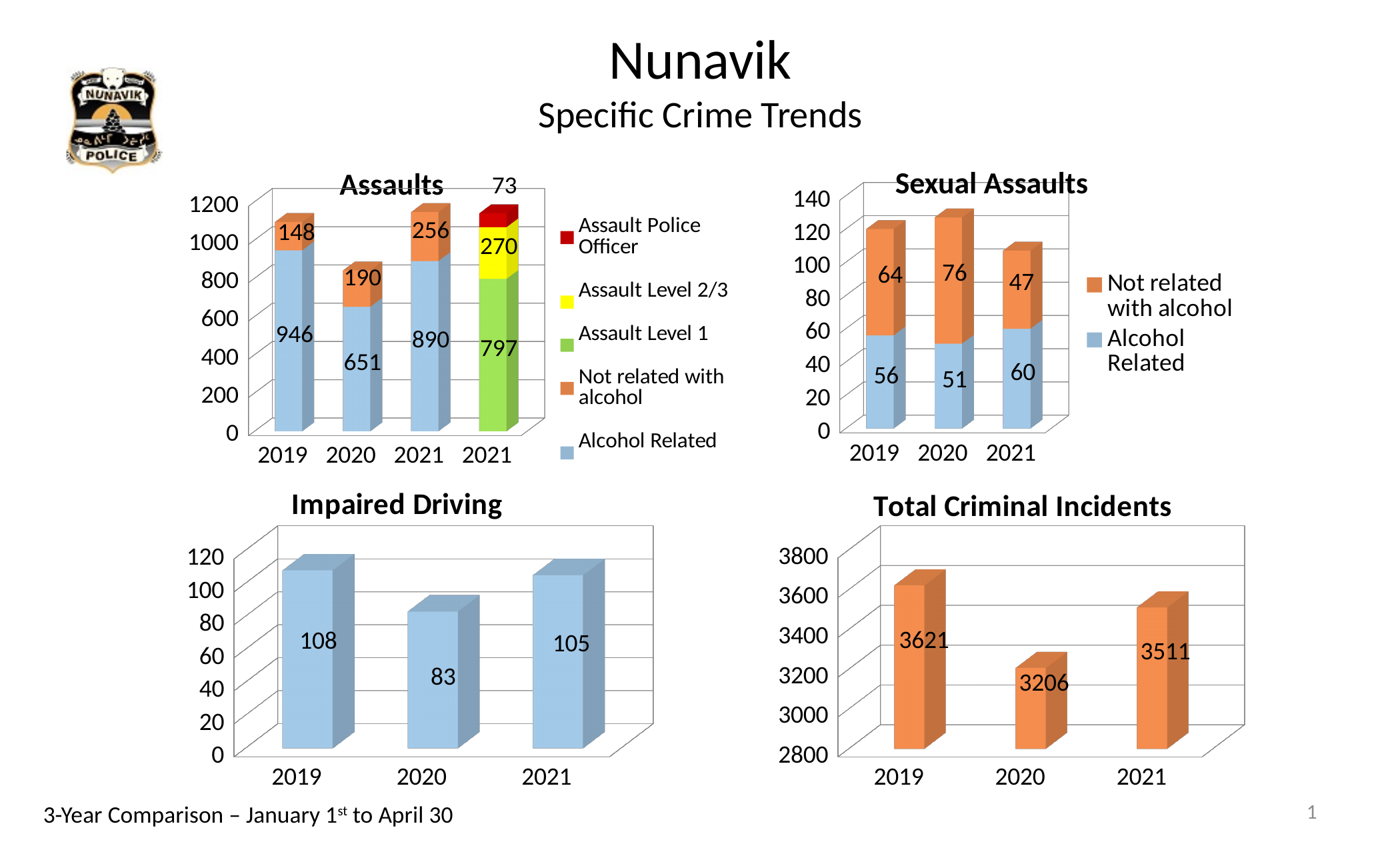
In the Sexual Assaults chart, is the Not related with alcohol value for 2020 larger than the value for 2021? Yes, 2020 (76) is larger than 2021 (47) What kind of chart is the Total Criminal Incidents chart? Bar chart In the Total Criminal Incidents chart, what is the difference between the 2019 and 2020 values? 415 In the Assaults chart, what is the Alcohol Related value for 2020? 651 In the Impaired Driving chart, which year has the lowest value? 2020 How many years are shown on the x axis of the Impaired Driving chart? 3 How many series does the legend of the Assaults chart list? 5 In the Sexual Assaults chart, what is the total of the stacked bar for 2020? 127 In the Sexual Assaults chart, what is the Alcohol Related value for 2021? 60 In the Total Criminal Incidents chart, which year has the highest value? 2019 In the Assaults chart, what is the Assault Level 2/3 value for 2021? 270 In the Impaired Driving chart, what is the value for 2020? 83